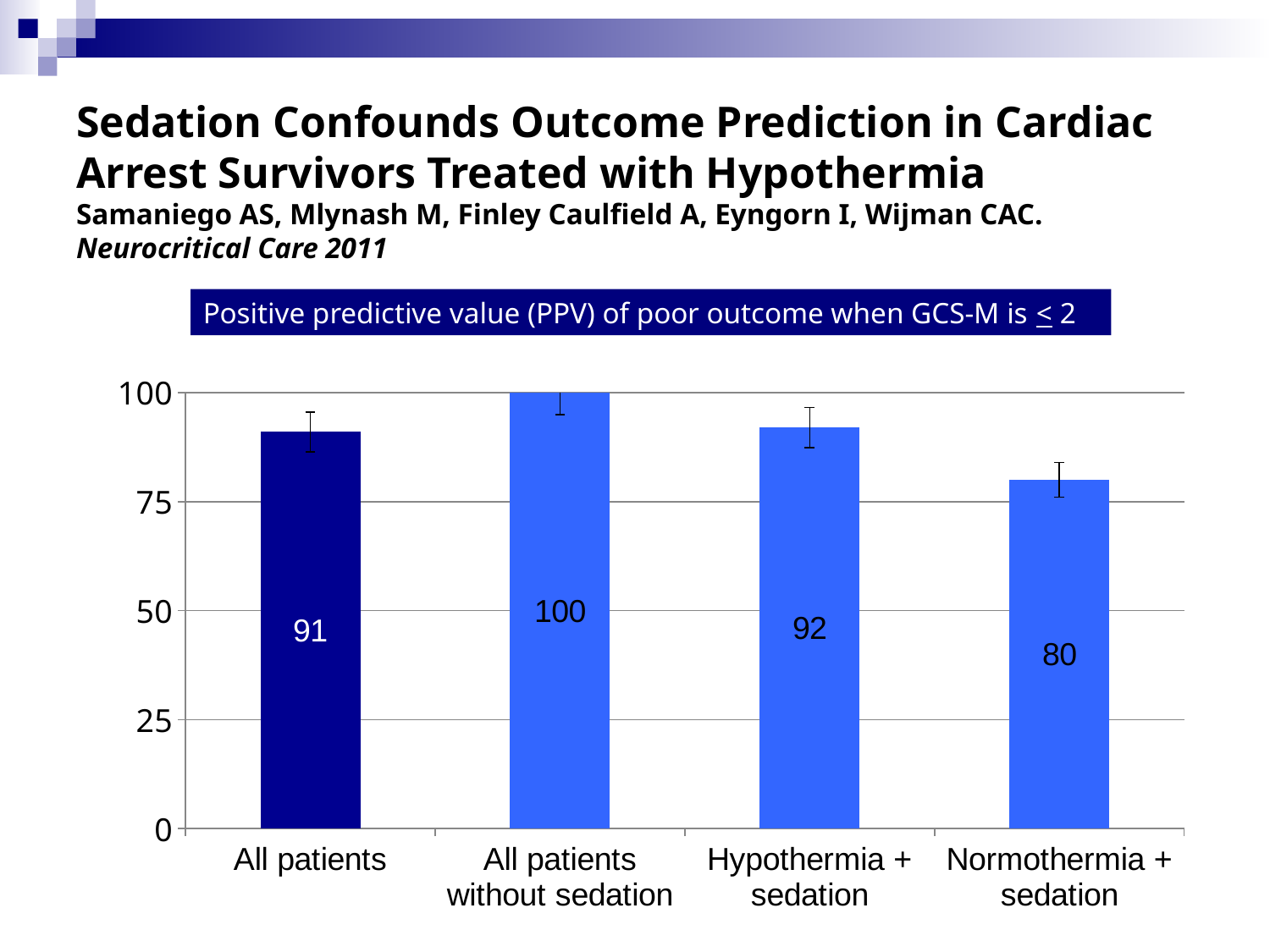
What is the title shown above the chart? Positive predictive value (PPV) of poor outcome when GCS-M is ≤ 2 What is the PPV value for Hypothermia + sedation? 92 How many categories are shown on the x axis of the chart? 4 What is the PPV value for Normothermia + sedation? 80 Which category has the lowest PPV value? Normothermia + sedation What is the difference between the PPV for All patients without sedation and Normothermia + sedation? 20 Which is larger, the PPV for All patients without sedation or for Hypothermia + sedation? All patients without sedation What is the difference between the PPV for Hypothermia + sedation and Normothermia + sedation? 12 What is the PPV value for All patients without sedation? 100 What kind of chart is shown on the slide? Bar chart What is the PPV value for All patients? 91 Which category has the highest PPV value? All patients without sedation